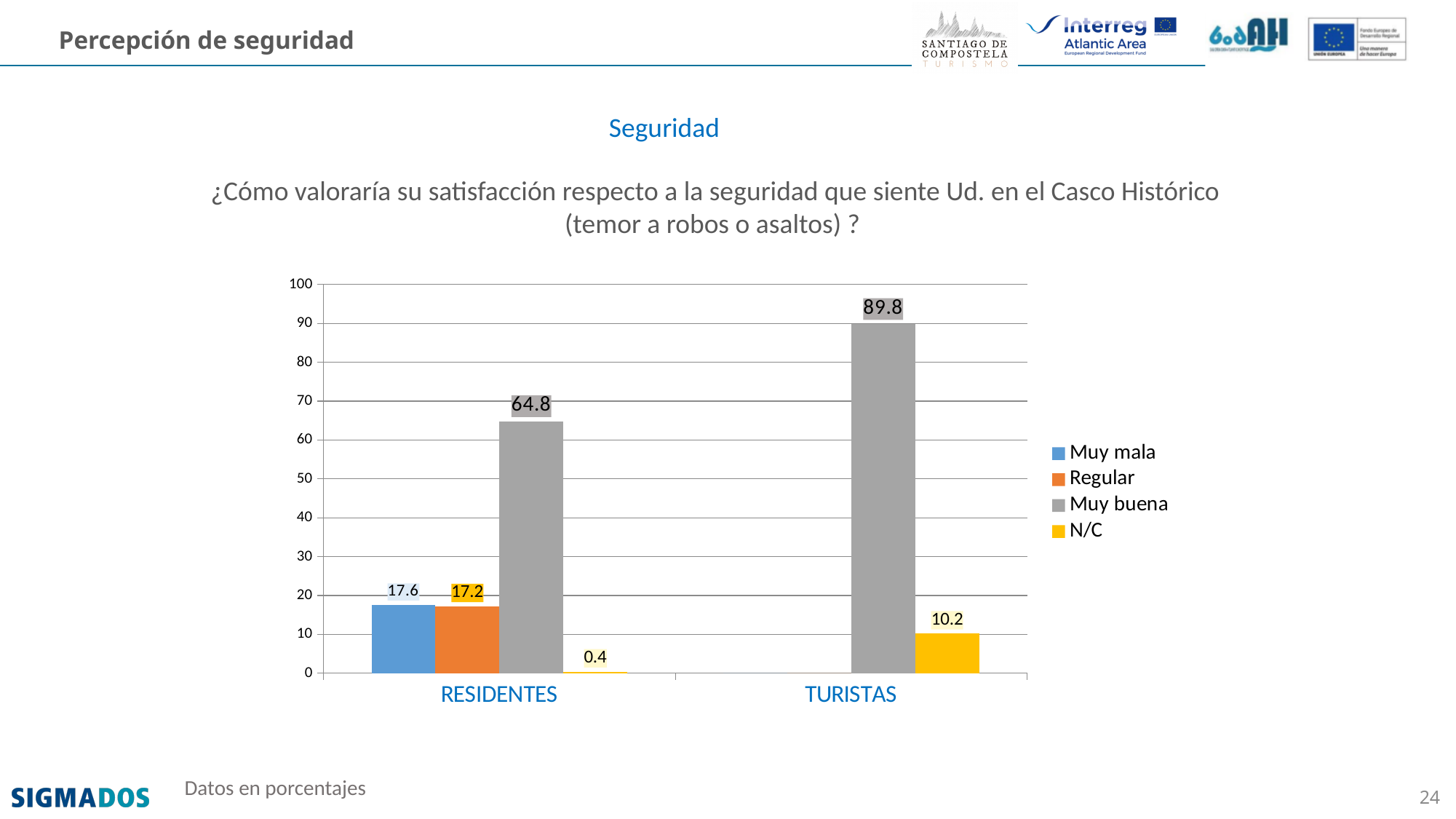
What kind of chart is shown on the slide? Bar chart Which is larger: the N/C value for TURISTAS or the N/C value for RESIDENTES? TURISTAS What is the value for Muy buena among TURISTAS? 89.8 What is the value for Regular among RESIDENTES? 17.2 Which series has the lowest value among RESIDENTES? N/C What is the value for Muy buena among RESIDENTES? 64.8 How many series does the legend list? 4 What is the value for Muy mala among RESIDENTES? 17.6 What is the difference between the Muy buena values for TURISTAS and RESIDENTES? 25 What is the value for N/C among TURISTAS? 10.2 How many categories are shown on the x axis? 2 Which series has the highest value among RESIDENTES? Muy buena